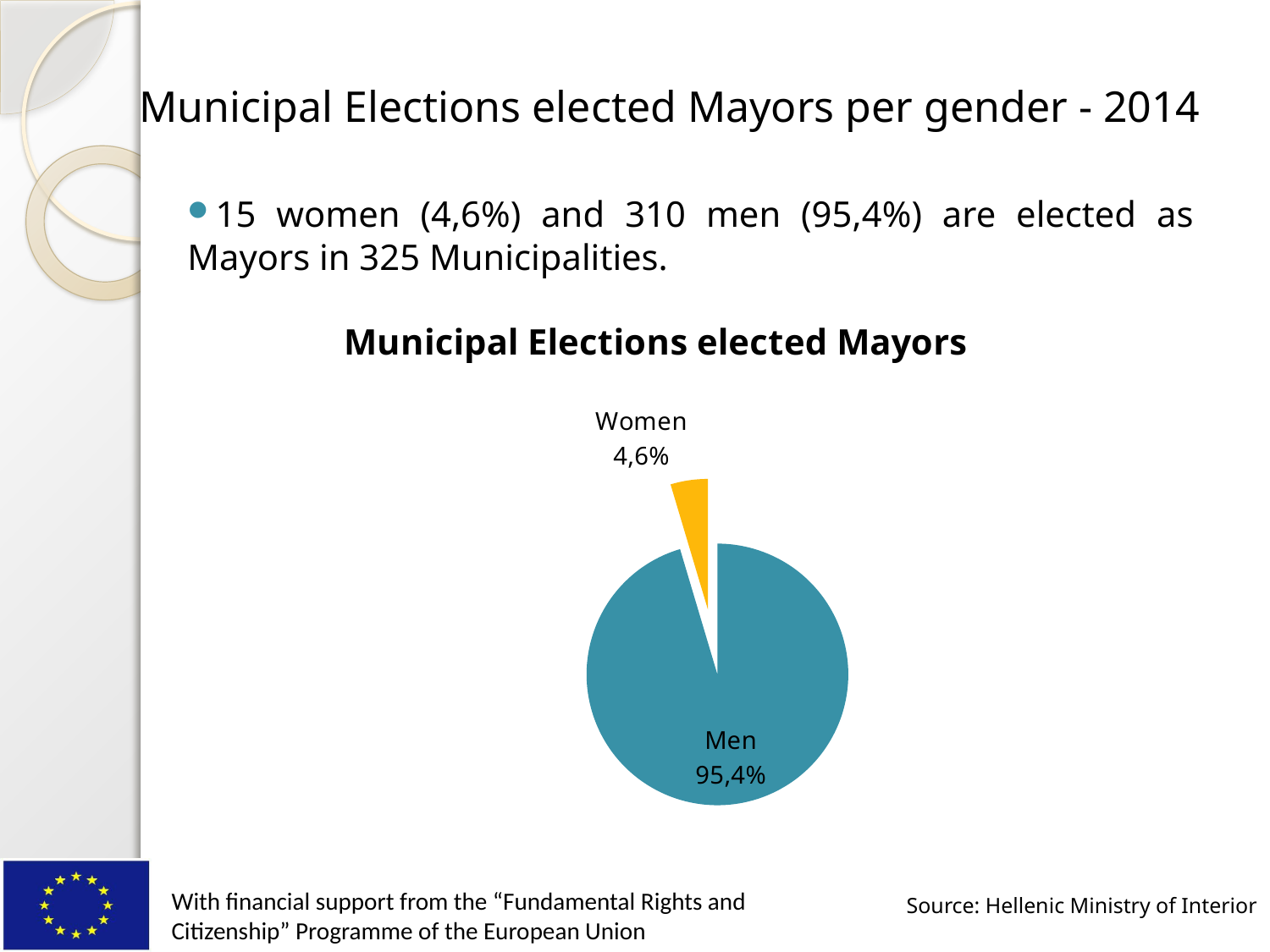
What kind of chart is shown on the slide? pie chart What share of the pie is labelled Women? 4,6% What share of the pie is labelled Men? 95,4% Which slice of the pie is the largest? Men Which slice of the pie is the smallest? Women Which is larger, the share for Men or the share for Women? Men How many slices does the pie chart have? 2 What is the chart's title? Municipal Elections elected Mayors What colour is the Women slice of the pie? yellow What is the difference in percentage points between the Men and Women shares? 90,8